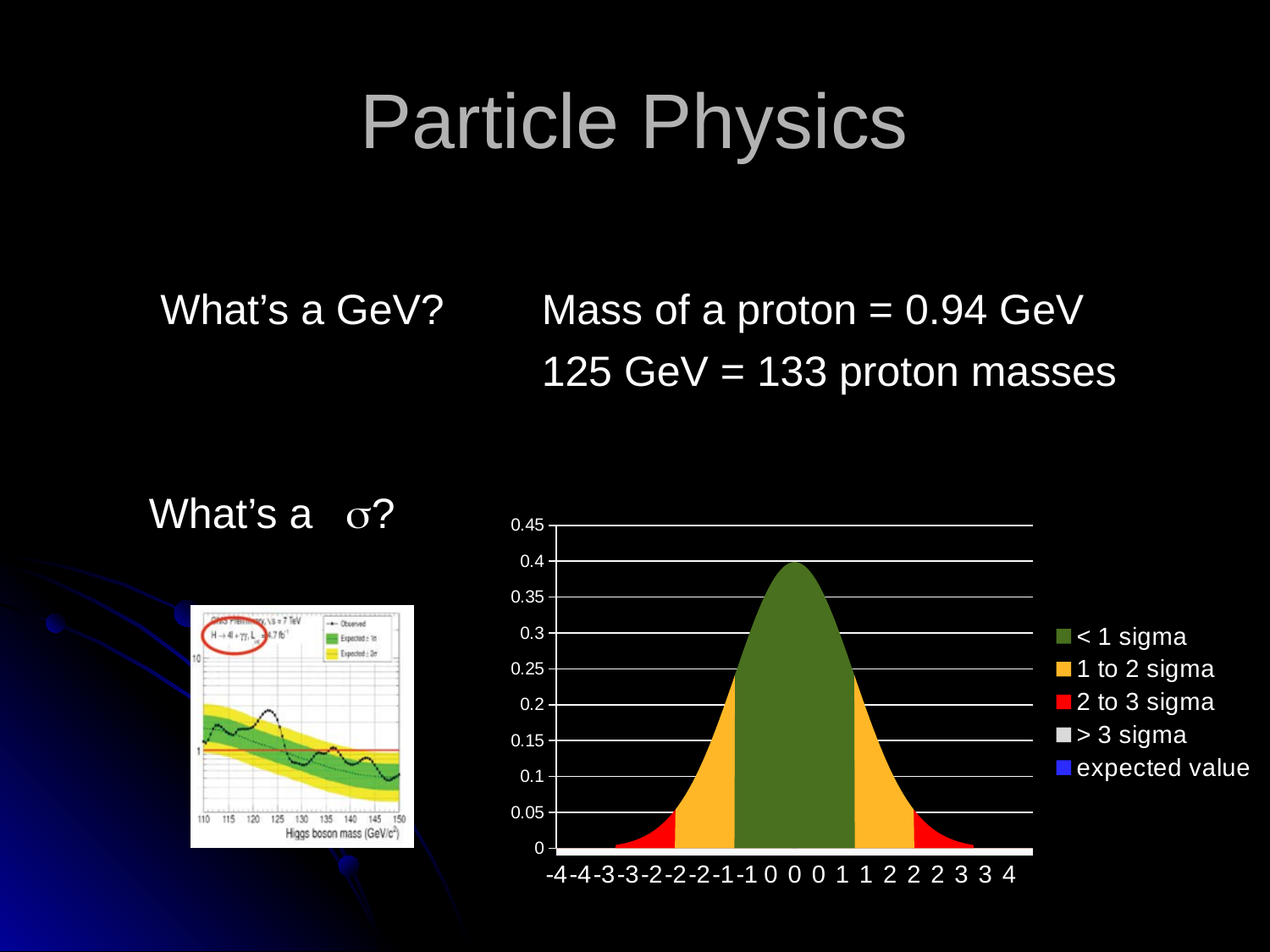
Which coloured region of the chart reaches the highest value? < 1 sigma What kind of chart is shown on the right of the slide? area chart What colour represents the '2 to 3 sigma' series in the legend? red How many series does the legend of the chart list? 5 Is the peak value of the curve at 0 greater or less than 0.35? greater How many labels are shown along the x axis of the chart? 20 Is the value of the curve at -4 greater or less than 0.05? less Do the values rise or fall along the x axis from -4 to 0? rise Do the values rise or fall along the x axis from 0 to 4? fall What is the highest value shown on the y axis of the chart? 0.45